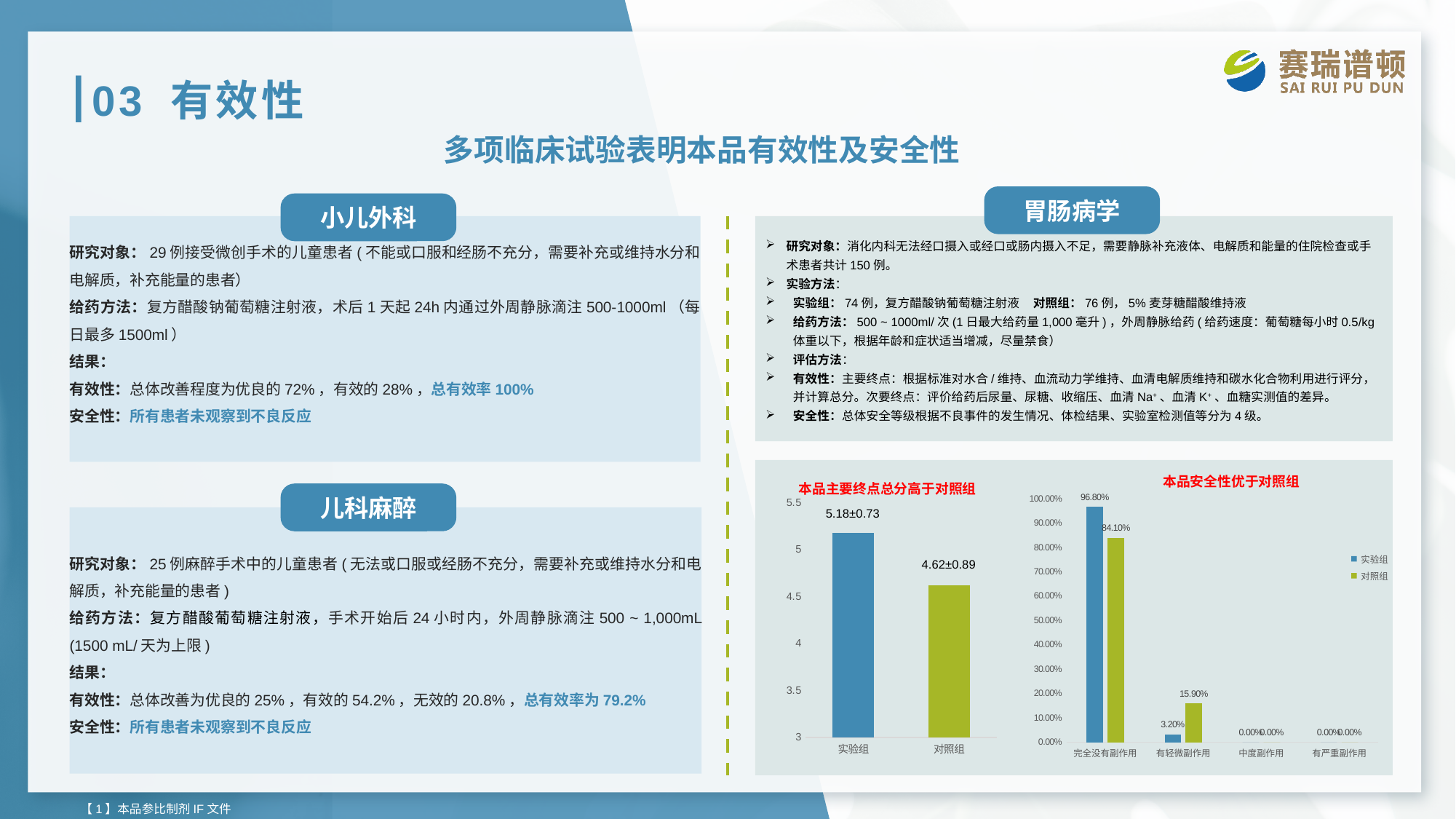
In the chart titled 本品安全性优于对照组, what is the value for 实验组 in the 完全没有副作用 category? 96.80% What kind of chart is the one titled 本品安全性优于对照组? bar chart In the chart titled 本品主要终点总分高于对照组, what is the value shown for 对照组? 4.62±0.89 In the chart titled 本品主要终点总分高于对照组, which group has the higher bar? 实验组 In the chart titled 本品安全性优于对照组, what is the value for 对照组 in the 有轻微副作用 category? 15.90% In the chart titled 本品安全性优于对照组, how many series does the legend list? 2 In the chart titled 本品安全性优于对照组, what is the value for 实验组 in the 有轻微副作用 category? 3.20% In the chart titled 本品安全性优于对照组, which colour represents 对照组? green In the chart titled 本品主要终点总分高于对照组, how many bars are plotted? 2 In the chart titled 本品安全性优于对照组, how many categories are shown on the x axis? 4 In the chart titled 本品主要终点总分高于对照组, what is the value shown for 实验组? 5.18±0.73 In the chart titled 本品安全性优于对照组, what is the difference between 实验组 and 对照组 in the 完全没有副作用 category? 12.70%